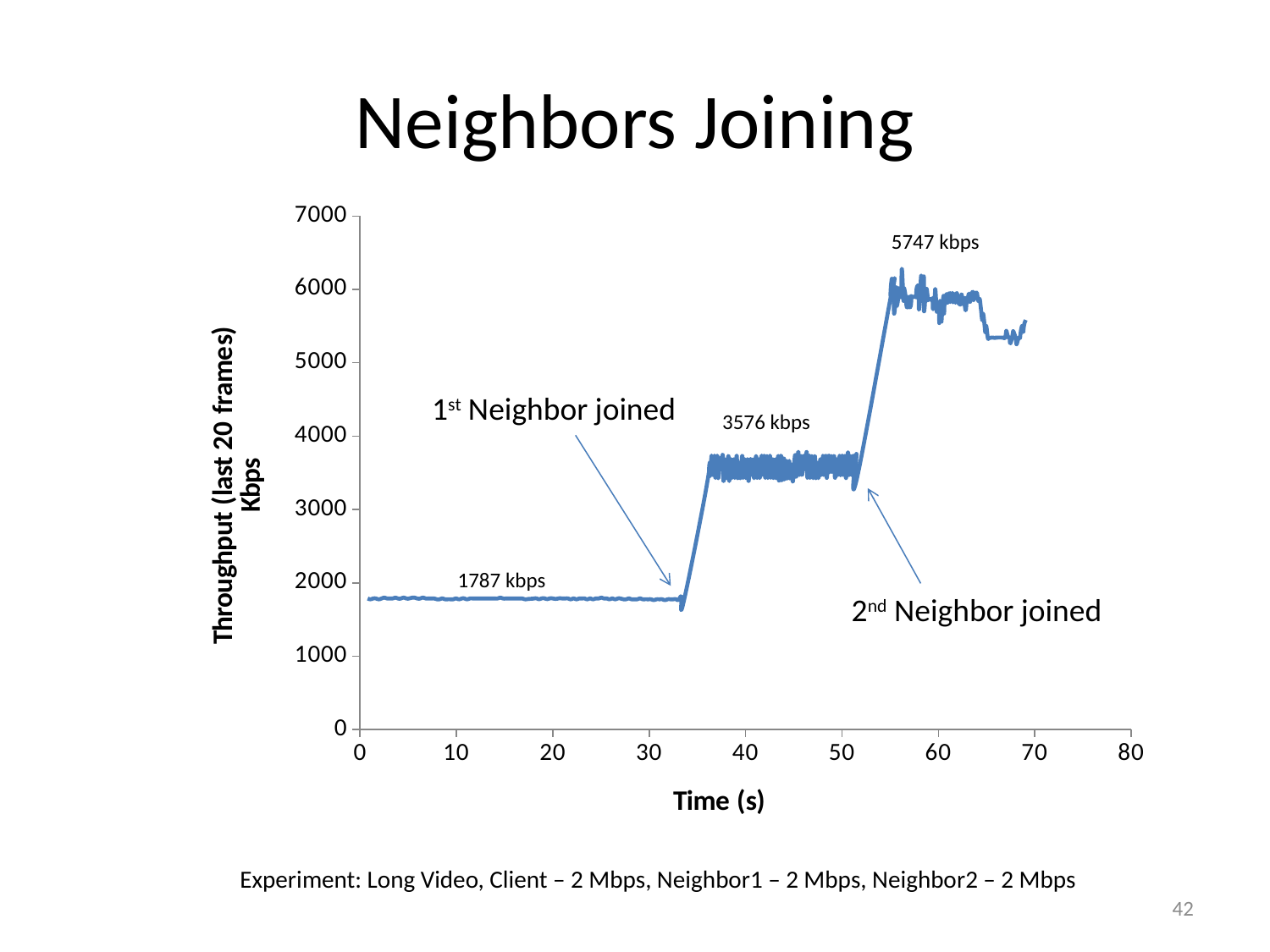
What is the throughput label for the plateau after the 1st neighbor joined? 3576 kbps What is the throughput label for the first plateau, before the 1st neighbor joined? 1787 kbps What is the difference between the 3576 kbps plateau and the 1787 kbps plateau? 1789 kbps Is the throughput at time 20 s greater or less than 2000? less What is the label of the x axis? Time (s) Is the throughput at time 60 s greater or less than 5000? greater Does throughput rise or fall over time as neighbors join? rise What is the throughput label for the plateau after the 2nd neighbor joined? 5747 kbps What is the difference between the 5747 kbps plateau and the 3576 kbps plateau? 2171 kbps What kind of chart is shown on the slide? line chart Which labeled plateau has the highest throughput? 5747 kbps Which labeled plateau has the lowest throughput? 1787 kbps